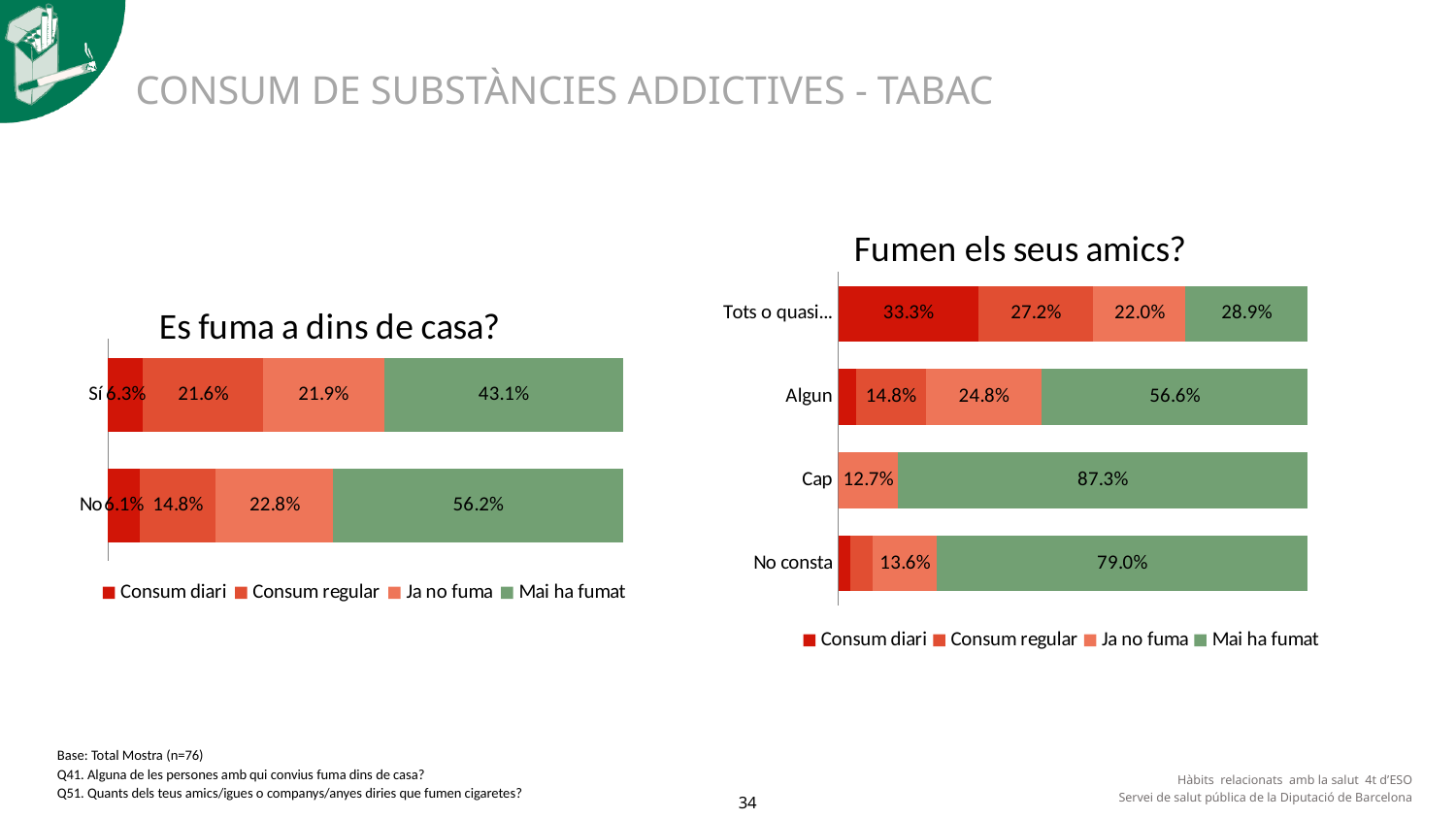
In the chart 'Fumen els seus amics?', what is the value of 'Mai ha fumat' for 'No consta'? 79.0% What type of chart is 'Fumen els seus amics?'? Stacked bar chart In the chart 'Es fuma a dins de casa?', what is the value of 'Consum regular' for the 'No' category? 14.8% In the chart 'Es fuma a dins de casa?', what is the difference between the 'Mai ha fumat' values for 'No' and 'Sí'? 13.1% In the chart 'Fumen els seus amics?', which category has the highest value for 'Mai ha fumat'? Cap How many series does the legend of the chart 'Es fuma a dins de casa?' list? 4 In the chart 'Es fuma a dins de casa?', what is the value of 'Mai ha fumat' for the 'Sí' category? 43.1% In the chart 'Es fuma a dins de casa?', which category has the larger 'Consum regular' value, 'Sí' or 'No'? Sí In the chart 'Fumen els seus amics?', which category has the lowest value for 'Mai ha fumat'? Tots o quasi... How many categories are shown in the chart 'Fumen els seus amics?'? 4 In the chart 'Fumen els seus amics?', what is the value of 'Mai ha fumat' for 'Cap'? 87.3% In the chart 'Fumen els seus amics?', what is the value of 'Consum diari' for 'Tots o quasi...'? 33.3%